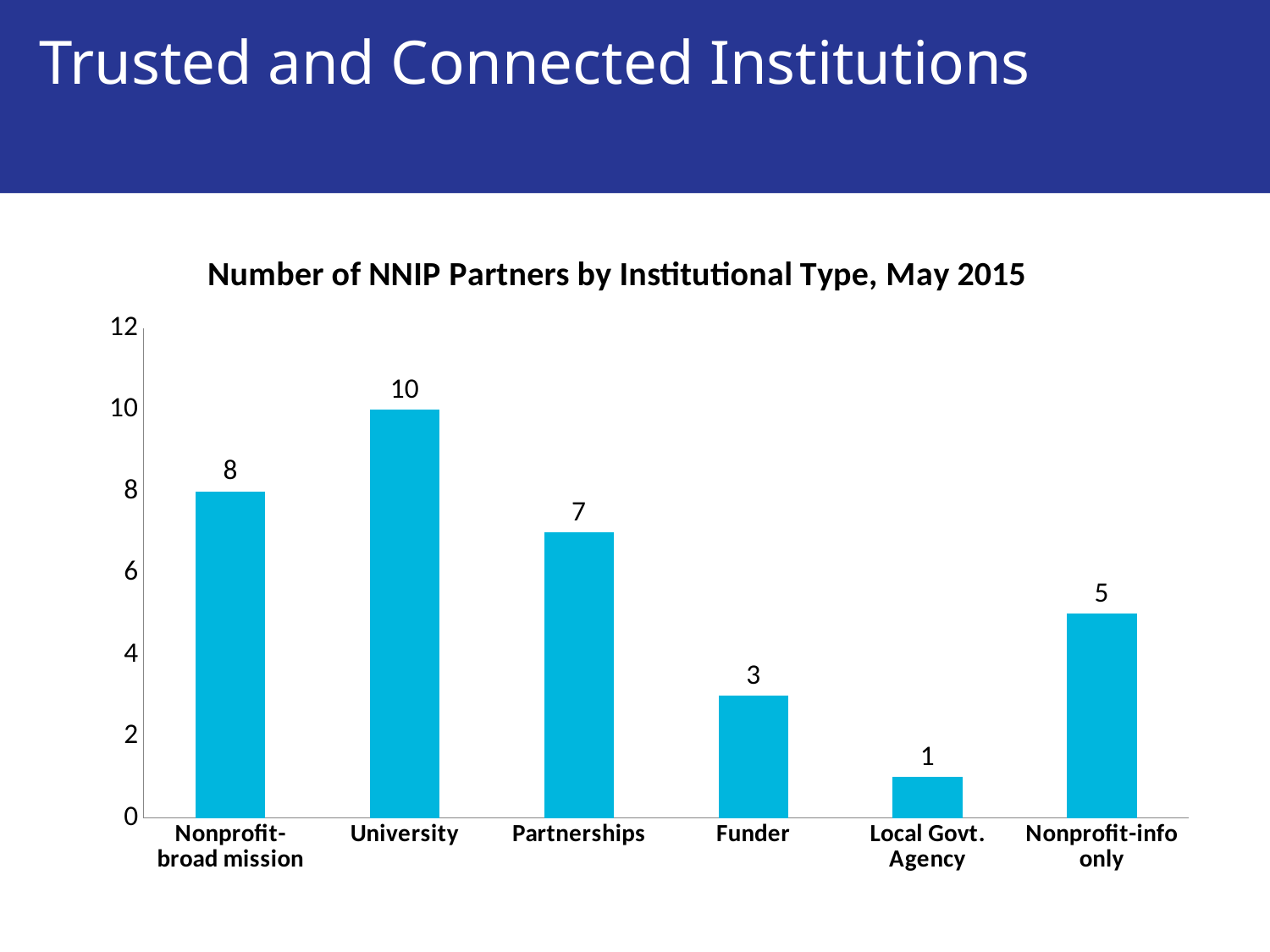
Is the value for Nonprofit-broad mission greater or less than 6? greater What kind of chart is shown on the slide? Bar chart What is the number of NNIP partners for University? 10 What is the number of NNIP partners for Nonprofit-info only? 5 How many institutional types are shown on the chart? 6 Which institutional type has the highest number of NNIP partners? University What is the title of the chart? Number of NNIP Partners by Institutional Type, May 2015 What is the difference between the number of partners for Nonprofit-broad mission and Local Govt. Agency? 7 What is the difference between the number of partners for University and Partnerships? 3 What is the number of NNIP partners for Funder? 3 Which has more NNIP partners, Partnerships or Nonprofit-info only? Partnerships Which institutional type has the lowest number of NNIP partners? Local Govt. Agency